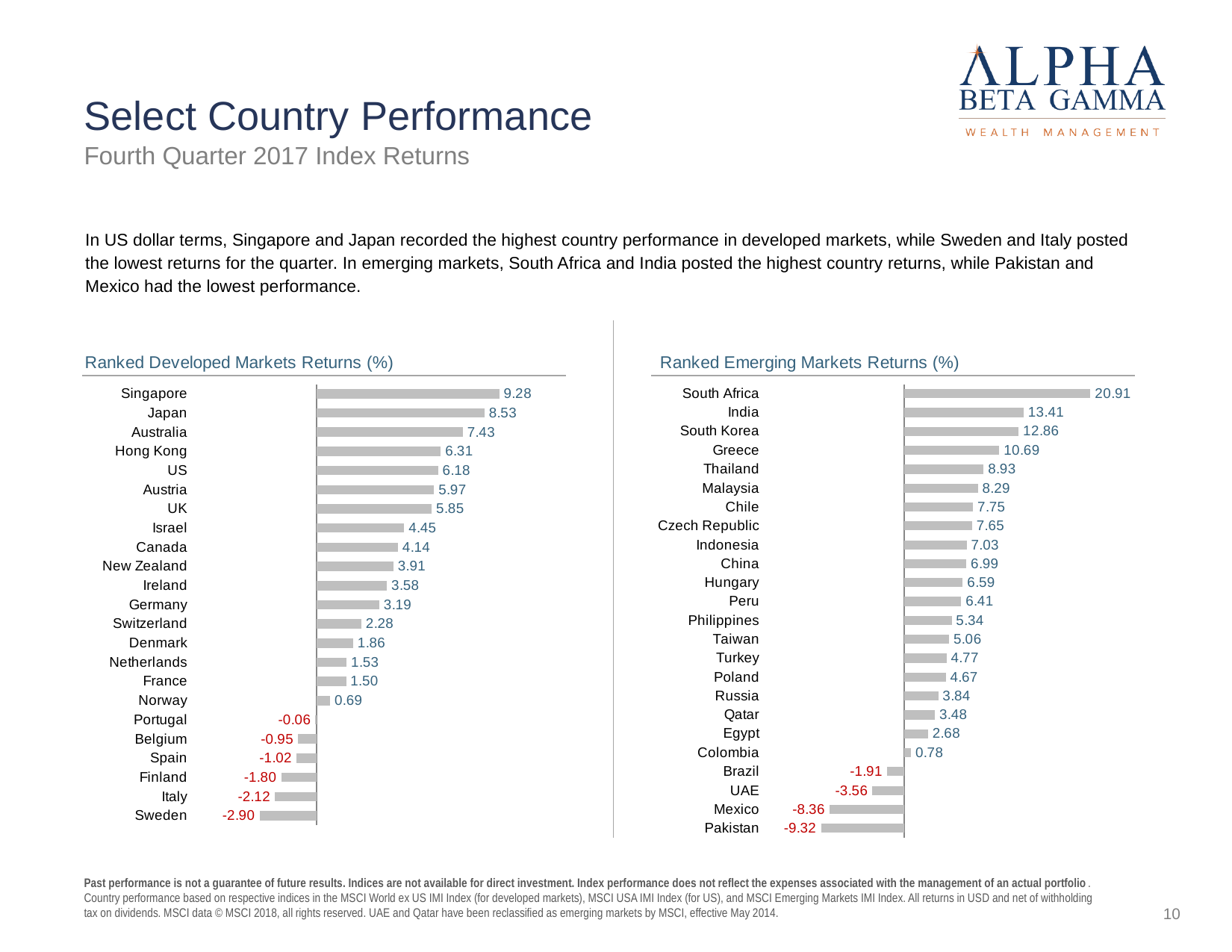
In the Ranked Developed Markets Returns (%) chart, what is the value for Japan? 8.53 In the Ranked Emerging Markets Returns (%) chart, which country has the lowest return? Pakistan In the Ranked Developed Markets Returns (%) chart, which is larger, the value for Canada or the value for Ireland? Canada In the Ranked Emerging Markets Returns (%) chart, which is larger, the value for Chile or the value for Indonesia? Chile In the Ranked Developed Markets Returns (%) chart, which country has the highest return? Singapore What kind of chart is the Ranked Emerging Markets Returns (%) chart? Bar chart How many countries are shown in the Ranked Developed Markets Returns (%) chart? 23 In the Ranked Emerging Markets Returns (%) chart, what is the difference between the values for South Africa and India? 7.50 In the Ranked Emerging Markets Returns (%) chart, what is the value for Greece? 10.69 In the Ranked Developed Markets Returns (%) chart, what is the value for Portugal? -0.06 How many countries are shown in the Ranked Emerging Markets Returns (%) chart? 24 In the Ranked Developed Markets Returns (%) chart, what is the difference between the values for Singapore and Sweden? 12.18